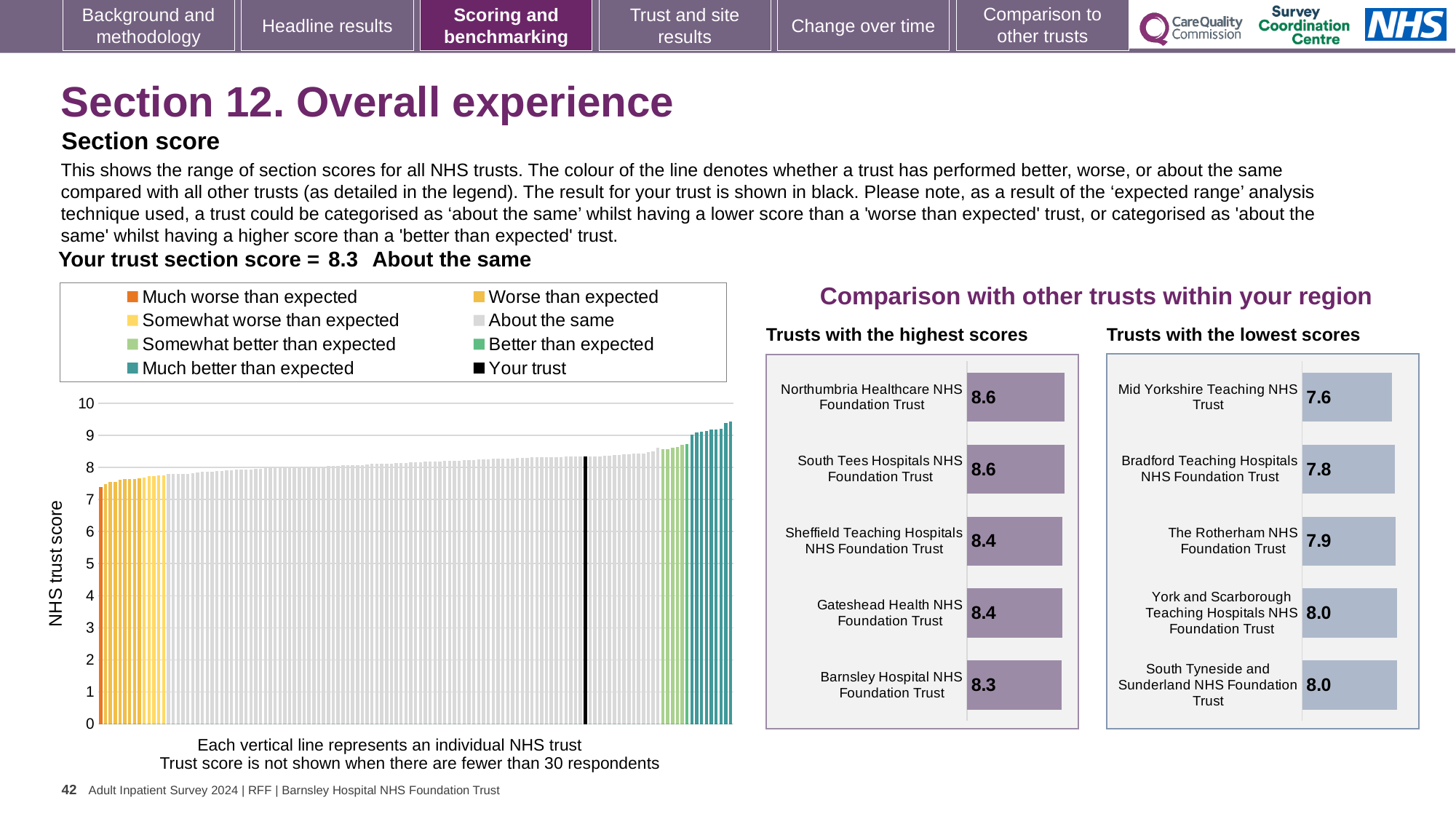
In the 'Trusts with the lowest scores' chart, what is the difference between the scores of Bradford Teaching Hospitals NHS Foundation Trust and Mid Yorkshire Teaching NHS Trust? 0.2 In the 'Trusts with the highest scores' chart, what is the difference between the scores of Northumbria Healthcare NHS Foundation Trust and Barnsley Hospital NHS Foundation Trust? 0.3 In the large chart on the left, is the value of the rightmost bar greater or less than 9? greater How many trusts are listed in the 'Trusts with the highest scores' chart? 5 What kind of chart is the large chart on the left showing the range of NHS trust scores? Bar chart In the large chart on the left, do the trust scores rise or fall from left to right? Rise In the 'Trusts with the highest scores' chart, what is the score for Barnsley Hospital NHS Foundation Trust? 8.3 In the 'Trusts with the highest scores' chart, what is the score for Northumbria Healthcare NHS Foundation Trust? 8.6 In the large chart on the left showing the range of section scores, how many entries does the legend list? 8 In the 'Trusts with the lowest scores' chart, which trust has the lowest score? Mid Yorkshire Teaching NHS Trust In the 'Trusts with the lowest scores' chart, which has the higher score: The Rotherham NHS Foundation Trust or Bradford Teaching Hospitals NHS Foundation Trust? The Rotherham NHS Foundation Trust In the 'Trusts with the lowest scores' chart, what is the score for Mid Yorkshire Teaching NHS Trust? 7.6